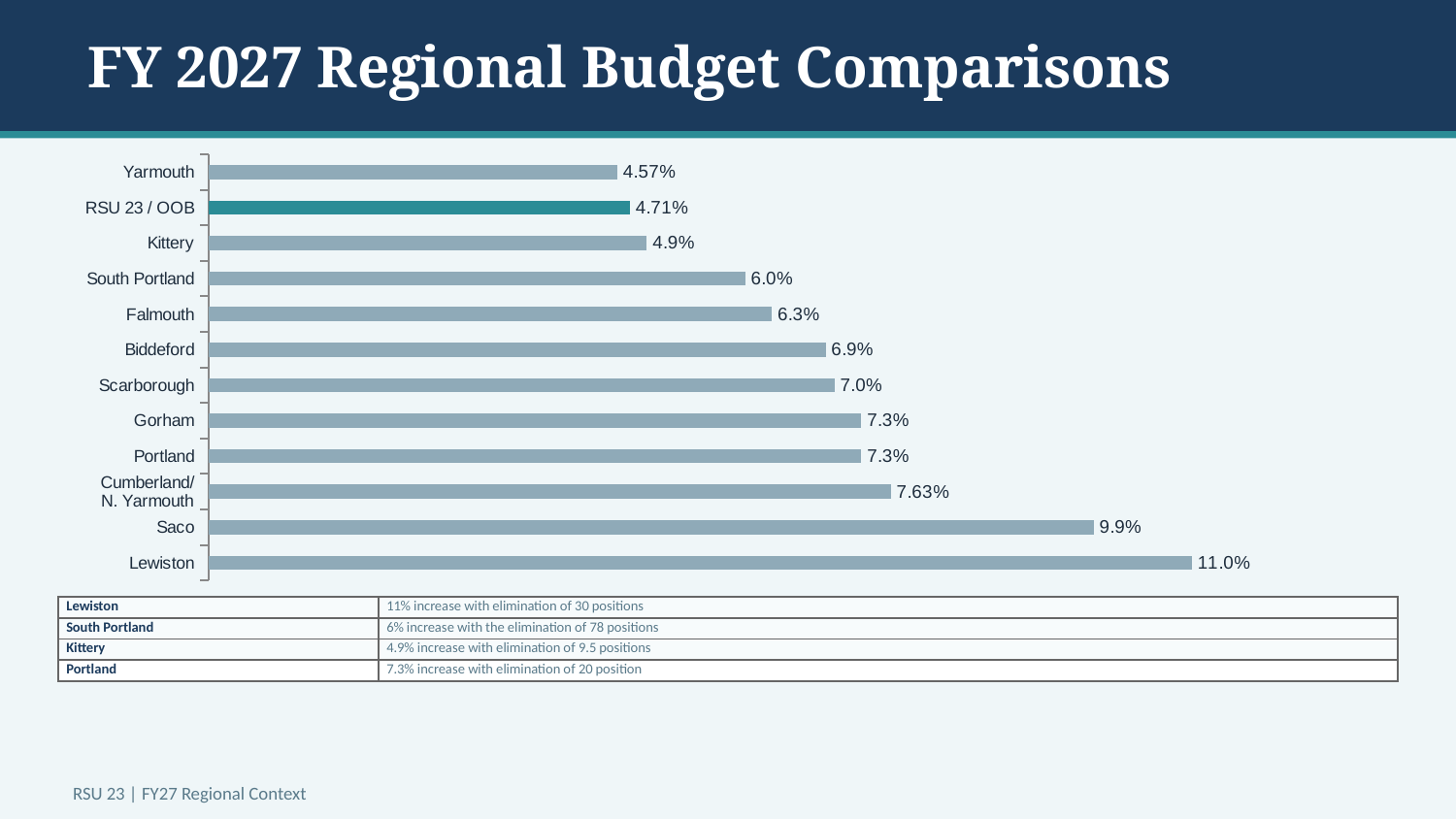
What is the value for Saco? 9.9% Which is larger, the value for Biddeford or the value for Falmouth? Biddeford Which district has the lowest value? Yarmouth What is the value for RSU 23 / OOB? 4.71% Which bar is shown in a different colour from the others? RSU 23 / OOB Which district has the highest value? Lewiston What kind of chart is shown on the slide? Bar chart What is the title of the slide containing the chart? FY 2027 Regional Budget Comparisons What is the difference between the values for RSU 23 / OOB and Yarmouth? 0.14% How many districts are shown in the chart? 12 What is the value for Cumberland/N. Yarmouth? 7.63% What is the difference between the values for Lewiston and Saco? 1.1%